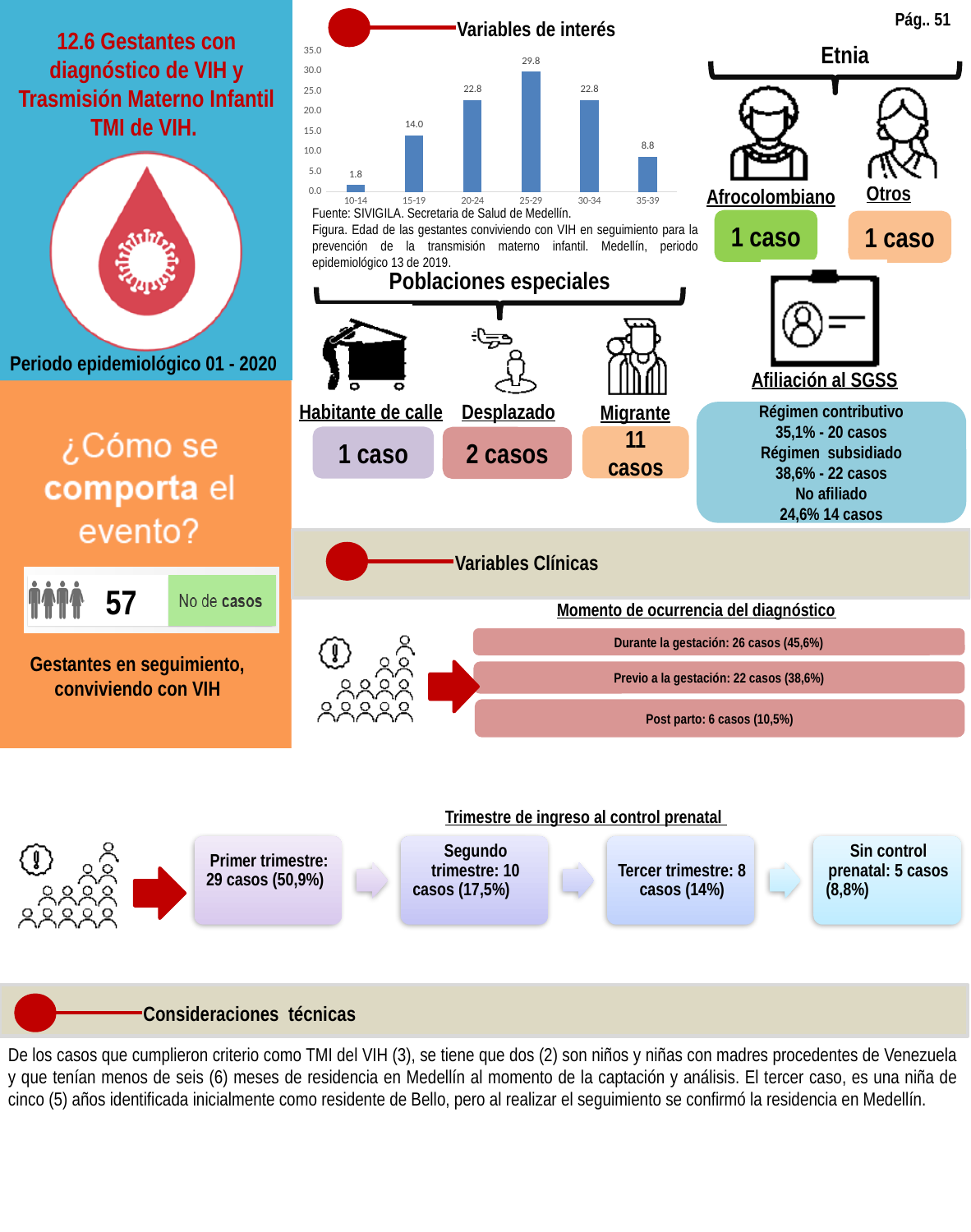
What is the value for the 25-29 age group in the bar chart? 29.8 Which age group has the highest value in the bar chart? 25-29 Is the value for the 30-34 age group in the bar chart greater or less than 20.0? greater What kind of chart is used to show the age of pregnant women living with HIV? bar chart Which age group has the lowest value in the bar chart? 10-14 What is the value for the 35-39 age group in the bar chart? 8.8 How many age groups are shown on the x axis of the bar chart? 6 What is the value for the 15-19 age group in the bar chart? 14.0 What is the source cited below the bar chart? SIVIGILA. Secretaria de Salud de Medellín. Which is larger in the bar chart, the value for 15-19 or the value for 35-39? 15-19 What is the difference between the values for the 25-29 and 15-19 age groups in the bar chart? 15.8 What is the value for the 10-14 age group in the bar chart? 1.8